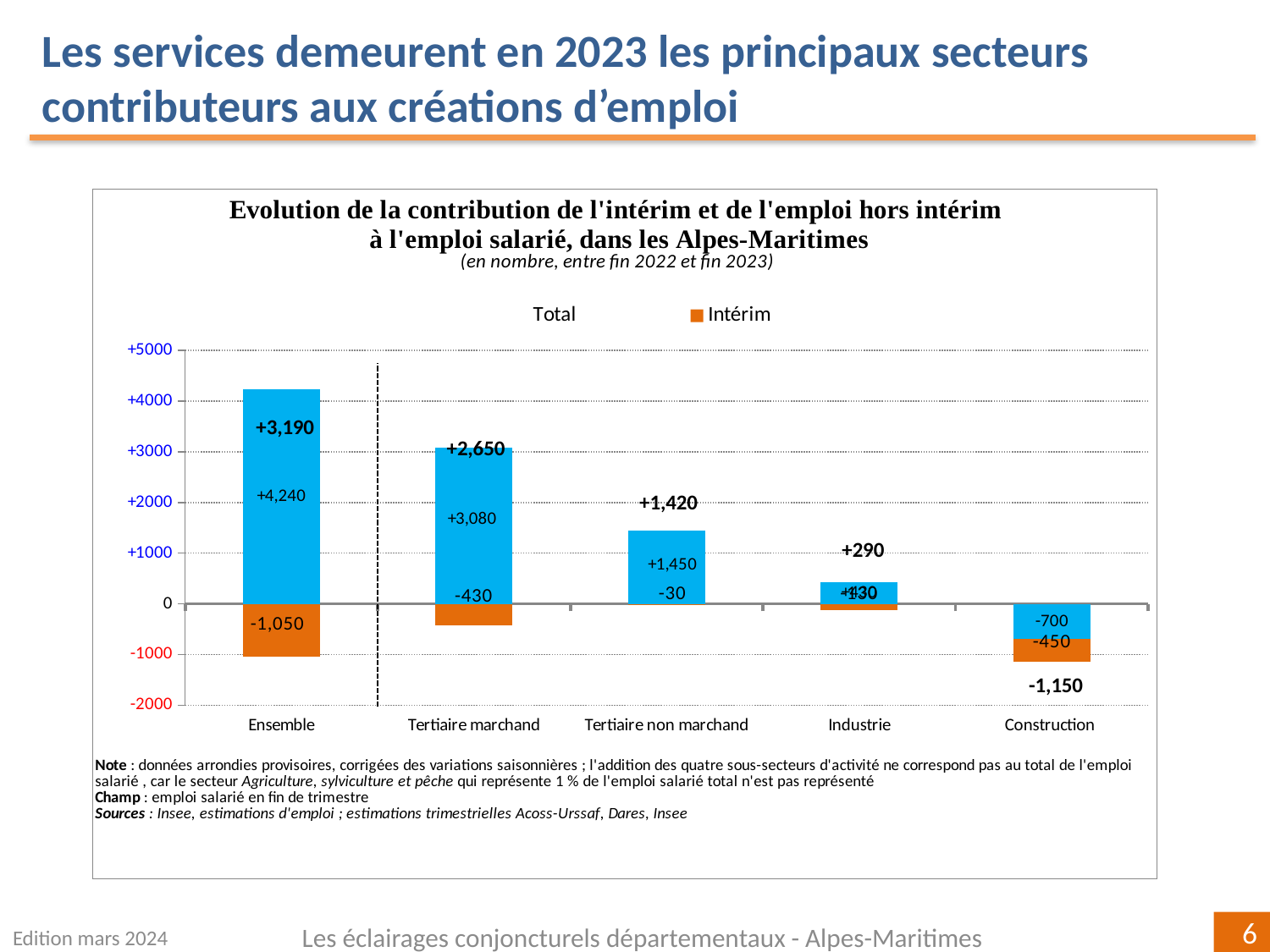
What is the Intérim value for Ensemble? -1,050 Which category has the lowest total value? Construction What is the Intérim value for Tertiaire marchand? -430 Which has the larger total value, Tertiaire non marchand or Industrie? Tertiaire non marchand What is the Intérim value for Construction? -450 How many categories are shown on the x axis? 5 What kind of chart is this? Bar chart Which category has the highest total value? Ensemble What is the difference between the total for Ensemble (+3,190) and the total for Tertiaire marchand (+2,650)? 540 What is the value of the blue (non-Intérim) segment for Tertiaire non marchand? +1,450 What is the total value shown for Tertiaire marchand? +2,650 What is the total value shown for Construction? -1,150